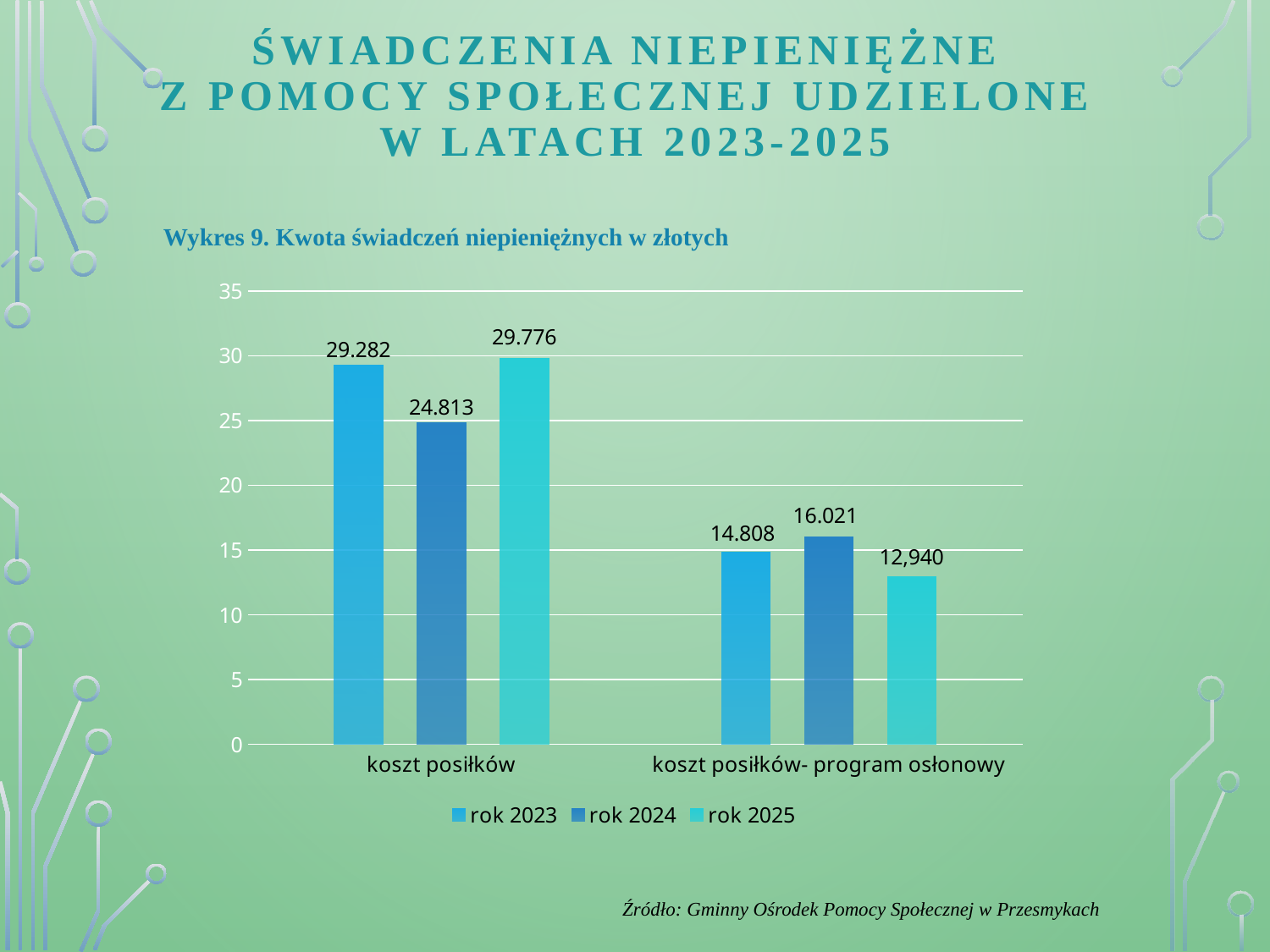
What is the title of the chart? Wykres 9. Kwota świadczeń niepieniężnych w złotych Which year has the highest value in the koszt posiłków category? rok 2025 What kind of chart is shown on the slide? bar chart How many categories are shown on the x axis? 2 Is the value for rok 2024 in the koszt posiłków category greater or less than 25? less What is the value for rok 2024 in the koszt posiłków- program osłonowy category? 16.021 How many series does the legend list? 3 What is the value for rok 2025 in the koszt posiłków- program osłonowy category? 12,940 What is the value for rok 2024 in the koszt posiłków category? 24.813 Which is larger: rok 2023 or rok 2024 in the koszt posiłków- program osłonowy category? rok 2024 What is the value for rok 2023 in the koszt posiłków category? 29.282 Which year has the lowest value in the koszt posiłków- program osłonowy category? rok 2025